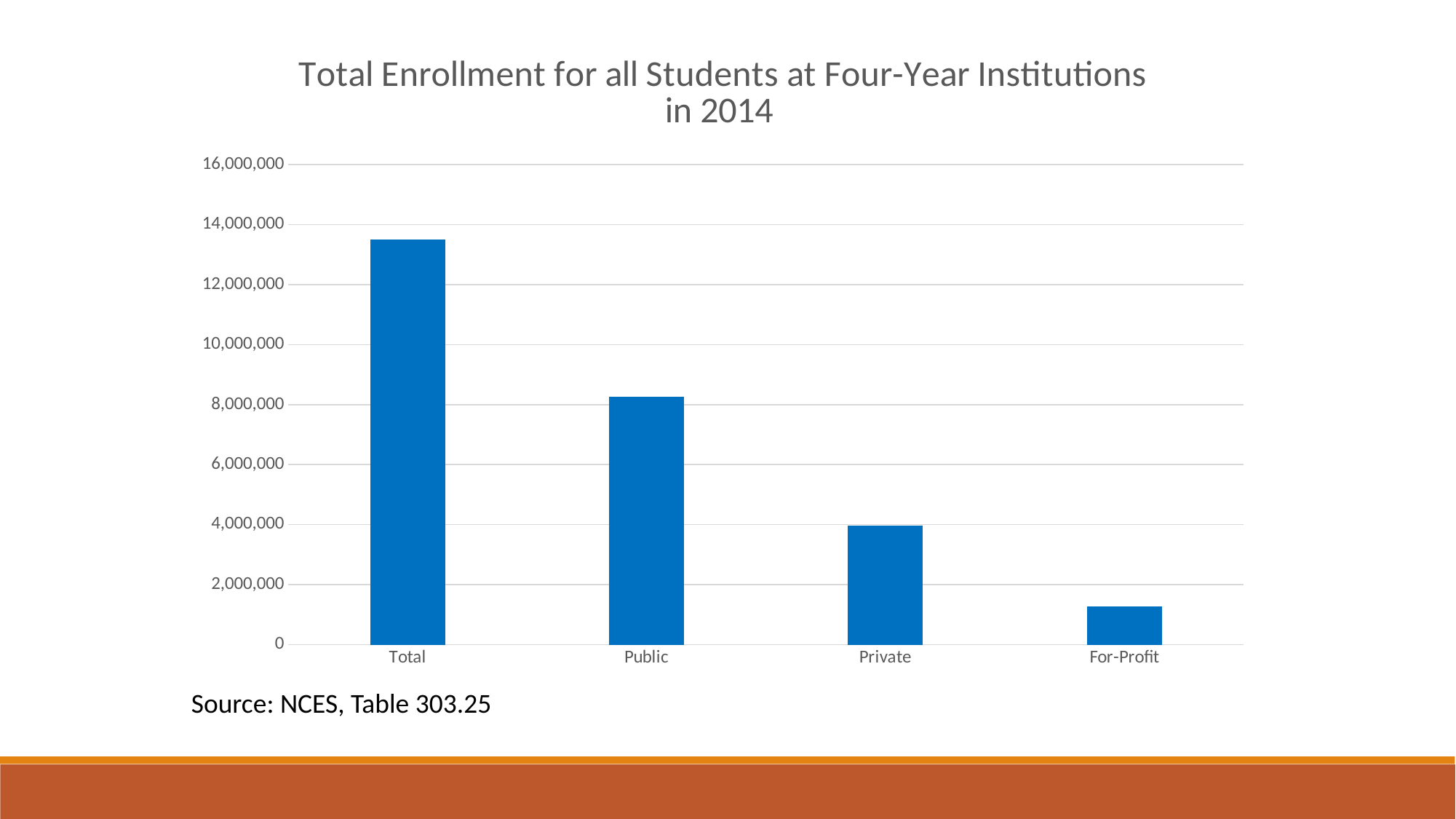
How many categories are shown on the x axis of the chart? 4 Which category has the highest enrollment in the chart? Total Is the value for Private greater or less than 6,000,000? less What is the title of the chart? Total Enrollment for all Students at Four-Year Institutions in 2014 Is the value for Total greater or less than 12,000,000? greater Is the value for Total greater or less than 14,000,000? less What kind of chart is shown on the slide? bar chart Which category has the lowest enrollment in the chart? For-Profit Which is larger, the value for Public or the value for Private? Public Do the bar values rise or fall from left to right across the x axis? fall